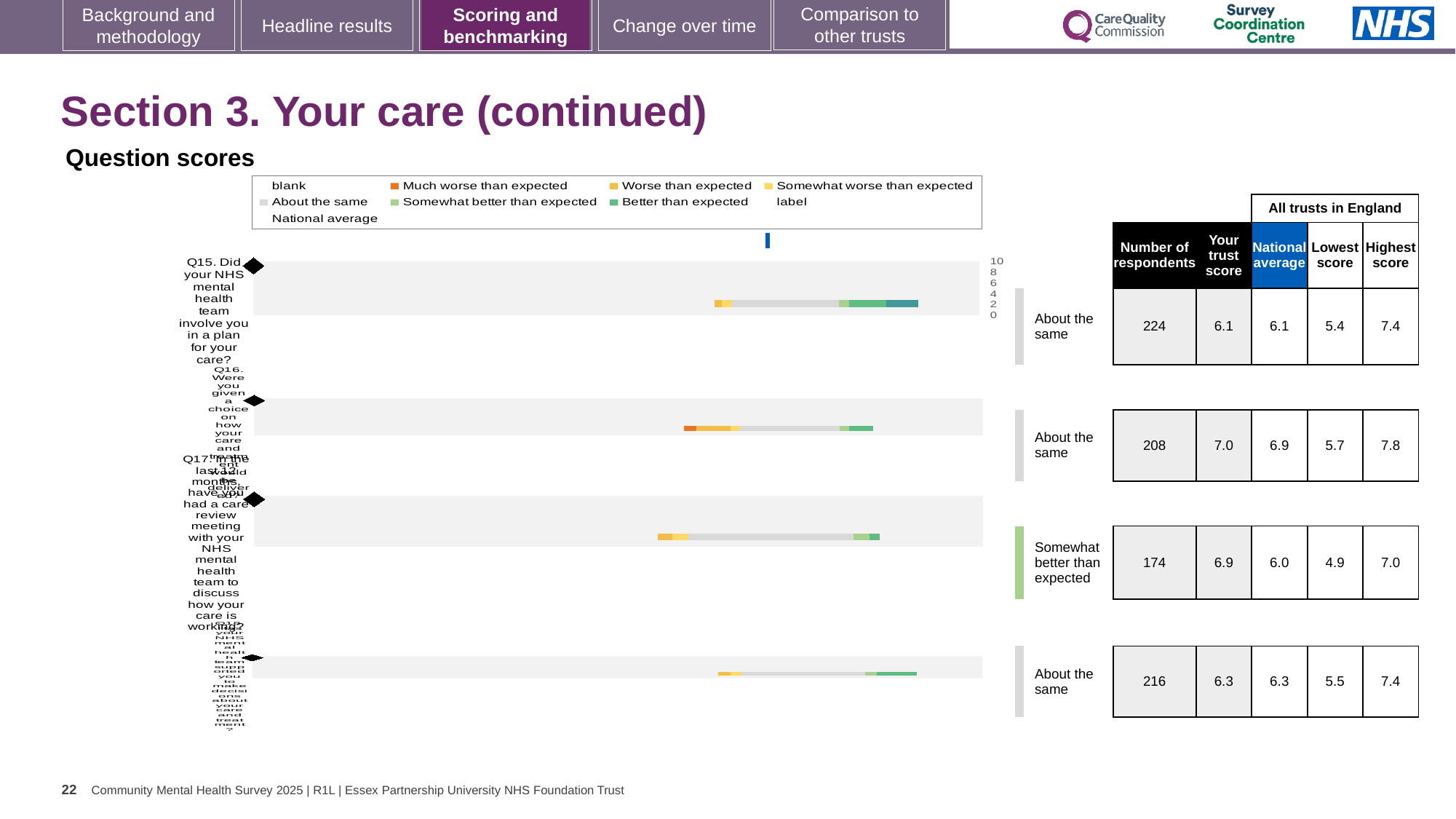
What is the trust score for Q15 (Did your NHS mental health team involve you in a plan for your care?)? 6.1 How many question bars are plotted in the chart? 4 What kind of chart is used to show the question scores on this slide? bar chart What is the highest score among all trusts in England for Q16? 7.8 How many respondents answered Q16 (Were you given a choice on how your care and treatment would be delivered)? 208 What is the difference between the trust score and the national average for Q17? 0.9 What is the lowest score among all trusts in England for Q17? 4.9 Which question has the fewest respondents: Q15, Q16 or Q17? Q17 Is the trust score for Q16 larger or smaller than the national average for Q16? larger What is the national average score for Q17 (In the last 12 months, have you had a care review meeting with your NHS mental health team)? 6.0 Which question has the highest trust score: Q15, Q16 or Q17? Q16 How does the trust's result for Q17 compare with what is expected, according to the benchmark label? Somewhat better than expected